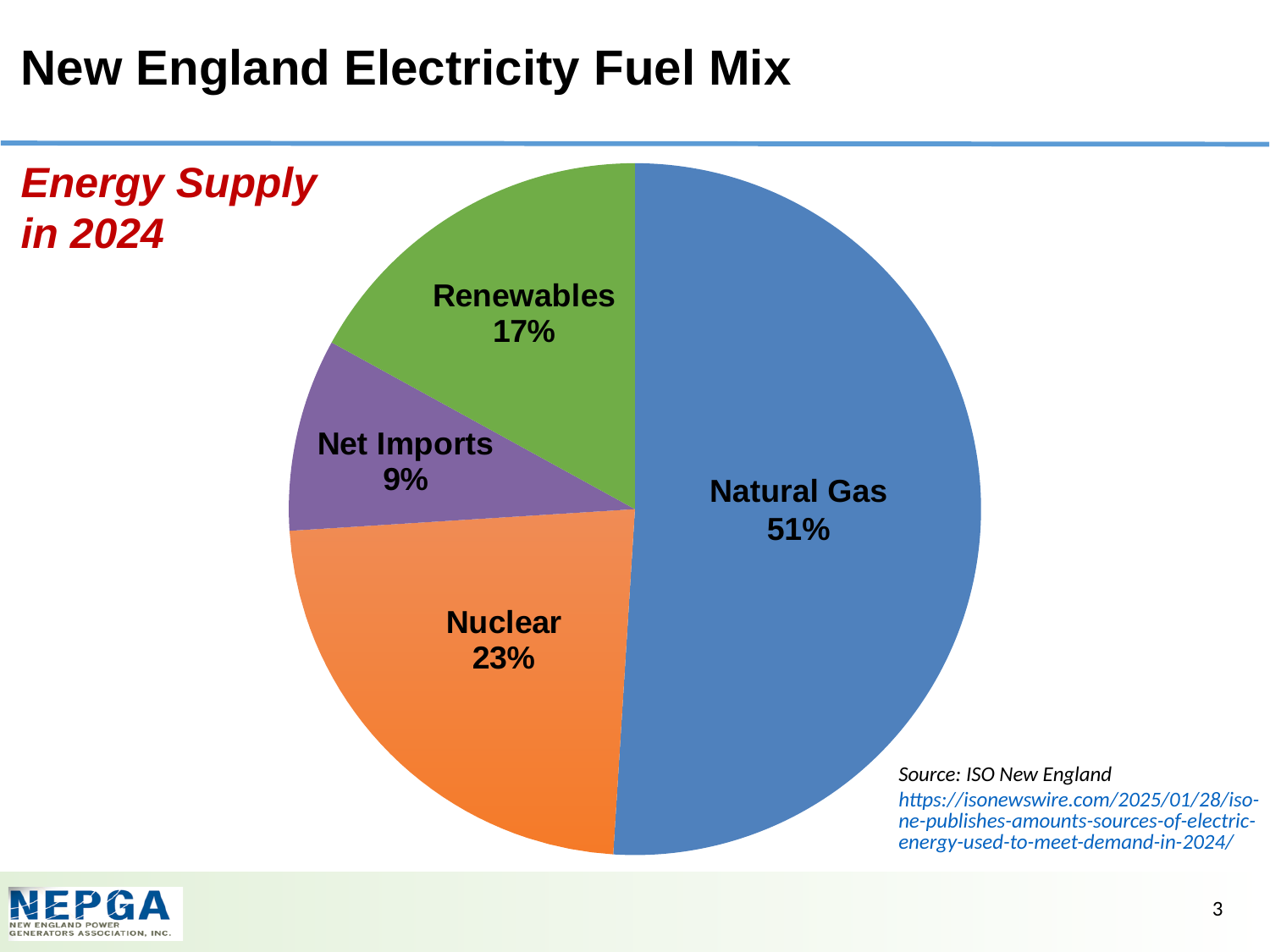
Which fuel source has the largest share of the 2024 energy supply? Natural Gas What share of the energy supply in 2024 comes from Nuclear? 23% How many fuel sources are shown in the pie chart? 4 What share of the energy supply in 2024 comes from Renewables? 17% How many percentage points larger is the Renewables share than the Net Imports share? 8 Which fuel source has the smallest share of the 2024 energy supply? Net Imports What share of the energy supply in 2024 comes from Net Imports? 9% Which has a larger share of the 2024 energy supply, Nuclear or Renewables? Nuclear What colour is the Nuclear slice of the pie chart? Orange What kind of chart is shown on the slide? Pie chart How many percentage points larger is the Natural Gas share than the Nuclear share? 28 What share of the energy supply in 2024 comes from Natural Gas? 51%